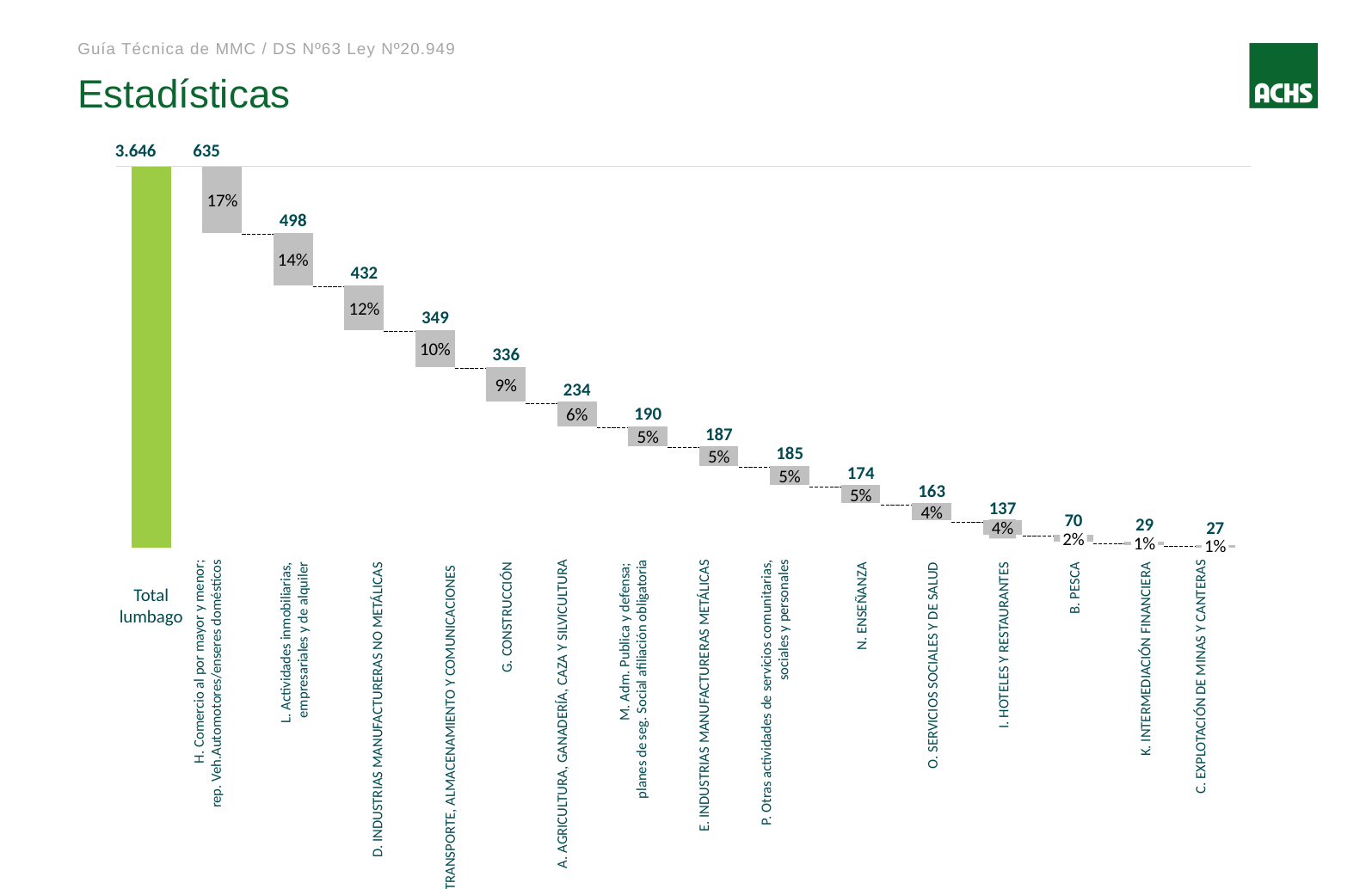
What kind of chart is shown on the slide? bar chart Which has a larger value, A. AGRICULTURA, GANADERÍA, CAZA Y SILVICULTURA or I. HOTELES Y RESTAURANTES? A. AGRICULTURA, GANADERÍA, CAZA Y SILVICULTURA What percentage is shown for B. PESCA? 2% What is the value shown for G. CONSTRUCCIÓN? 336 Which sector has the lowest value? C. EXPLOTACIÓN DE MINAS Y CANTERAS Do the sector values rise or fall from left to right along the x axis? fall What is the value shown for Total lumbago? 3.646 What is the value shown for N. ENSEÑANZA? 174 Which sector (excluding Total lumbago) has the highest value? H. Comercio al por mayor y menor; rep. Veh.Automotores/enseres domésticos What is the difference between the values for L. Actividades inmobiliarias, empresariales y de alquiler and D. INDUSTRIAS MANUFACTURERAS NO METÁLICAS? 66 How many sector categories are shown besides Total lumbago? 15 What percentage is shown for H. Comercio al por mayor y menor; rep. Veh.Automotores/enseres domésticos? 17%